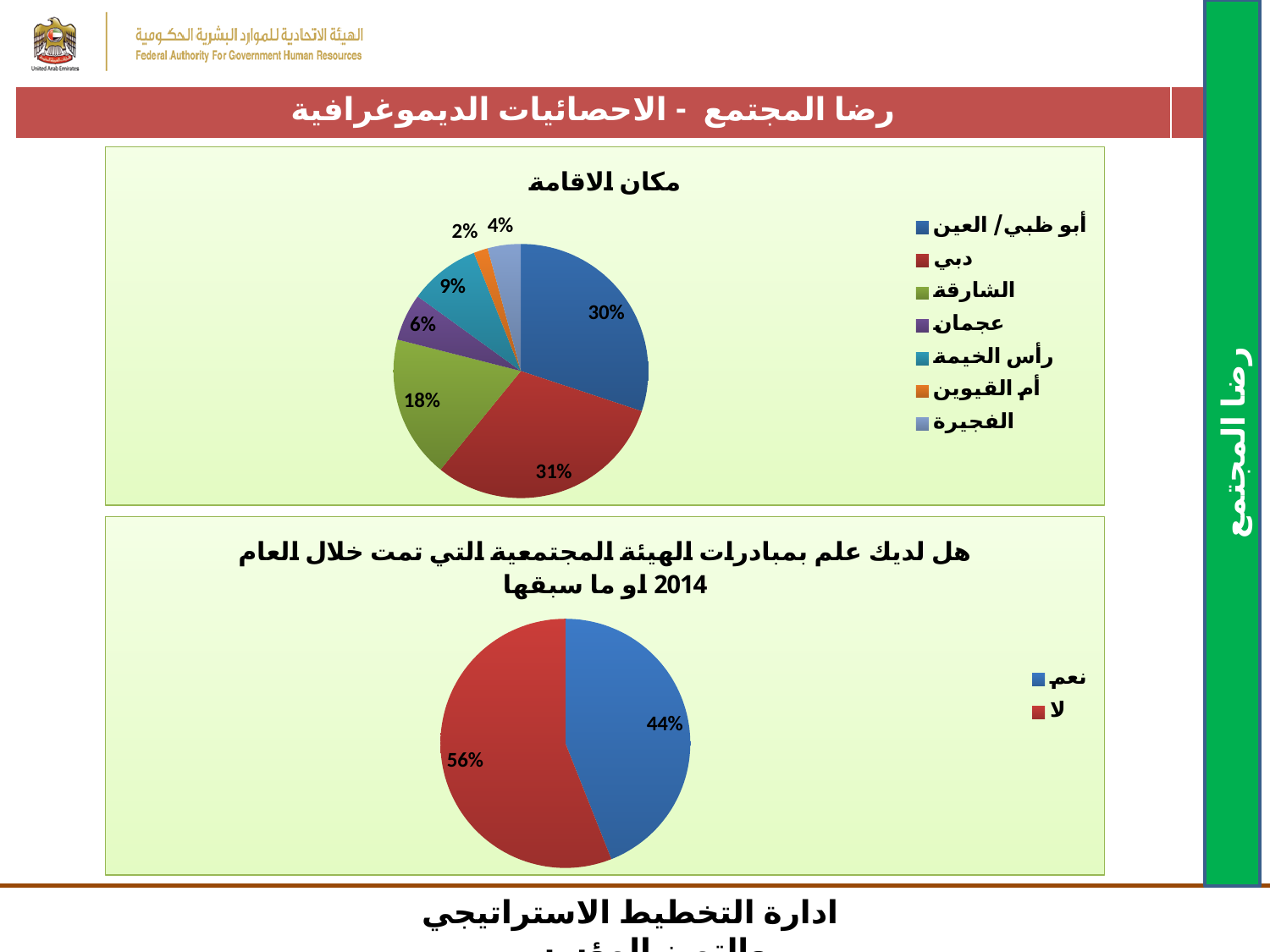
How many categories does the legend of the top chart titled "مكان الاقامة" list? 7 In the top chart titled "مكان الاقامة", what share of the pie is الشارقة? 18% In the top chart titled "مكان الاقامة", which is larger: the share of الفجيرة or the share of أم القيوين? الفجيرة In the bottom chart about awareness of the authority's community initiatives, what share answered نعم? 44% In the bottom chart about awareness of the authority's community initiatives, what is the difference between the shares of لا and نعم? 12% In the top chart titled "مكان الاقامة", what share of the pie is دبي? 31% In the top chart titled "مكان الاقامة", which category has the smallest share? أم القيوين In the bottom chart about awareness of the authority's community initiatives, which answer has the larger share? لا In the top chart titled "مكان الاقامة", what share of the pie is رأس الخيمة? 9% In the top chart titled "مكان الاقامة", which category has the largest share? دبي What kind of chart is the top chart titled "مكان الاقامة"? Pie chart In the top chart titled "مكان الاقامة", what is the difference between the shares of أبو ظبي/ العين and عجمان? 24%